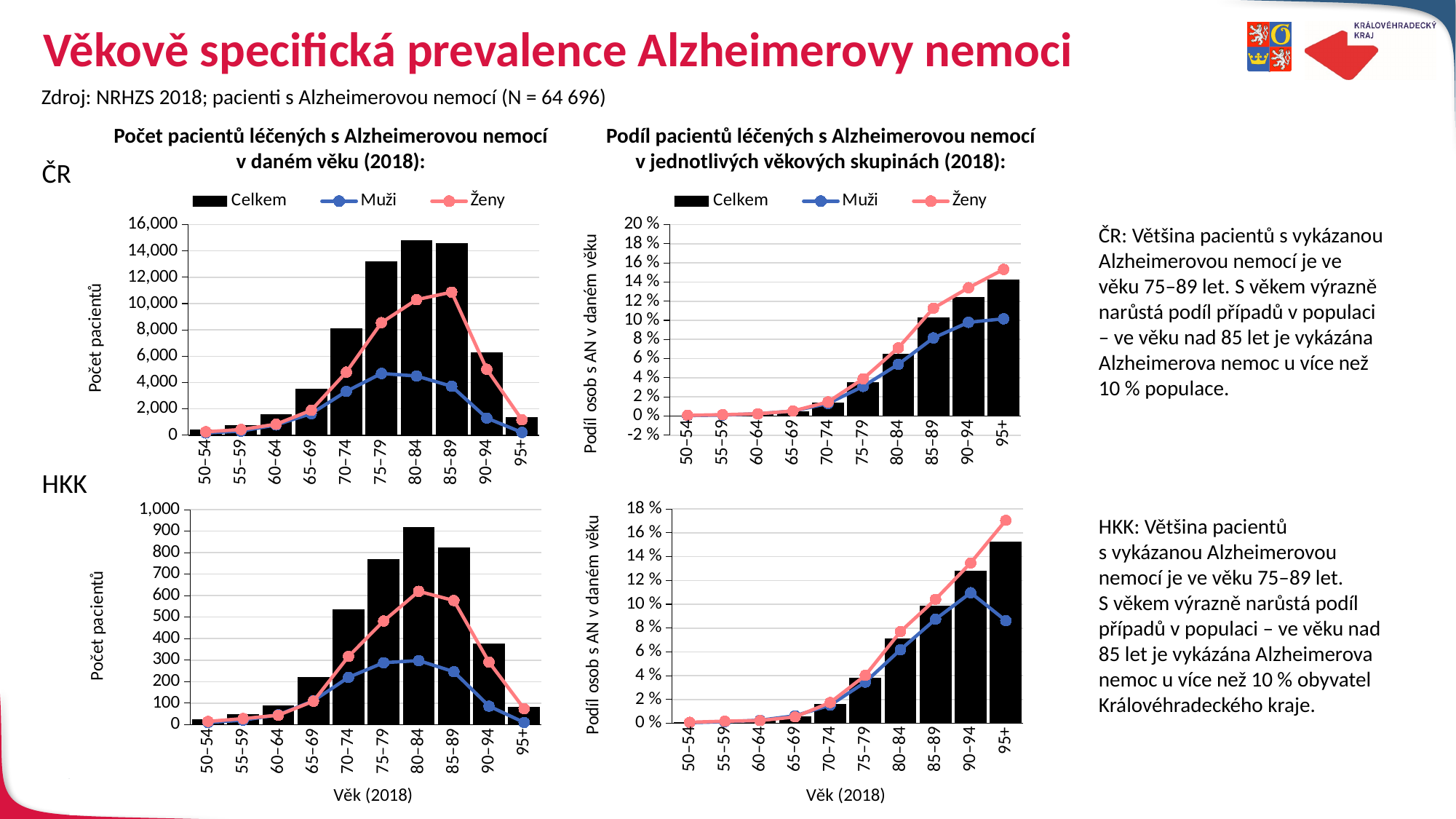
In the bottom-left chart (HKK, Počet pacientů), is the Celkem value for the 85–89 age group greater or less than 700? greater In the bottom-left chart (HKK, Počet pacientů), which age group has the highest Celkem bar? 80–84 In the top-right chart (ČR, Podíl pacientů), is the Celkem share for the 95+ age group greater or less than 10 %? greater In the top-right chart (ČR, Podíl pacientů), do the Celkem values rise or fall as age increases along the x axis? rise In the top-left chart (ČR, Počet pacientů), is the Celkem value for the 90–94 age group greater or less than 8,000? less In the top-right chart (ČR, Podíl pacientů), which is larger for the 95+ age group, Muži or Ženy? Ženy In the top-right chart (ČR, Podíl pacientů léčených s Alzheimerovou nemocí v jednotlivých věkových skupinách), which age group has the highest Celkem share? 95+ How many series does the legend of the top-left chart (ČR, Počet pacientů) list? 3 How many age groups are shown on the x axis of the bottom-left chart (HKK, Počet pacientů)? 10 In the top-left chart (ČR, Počet pacientů), which age group has the lowest Celkem bar? 50–54